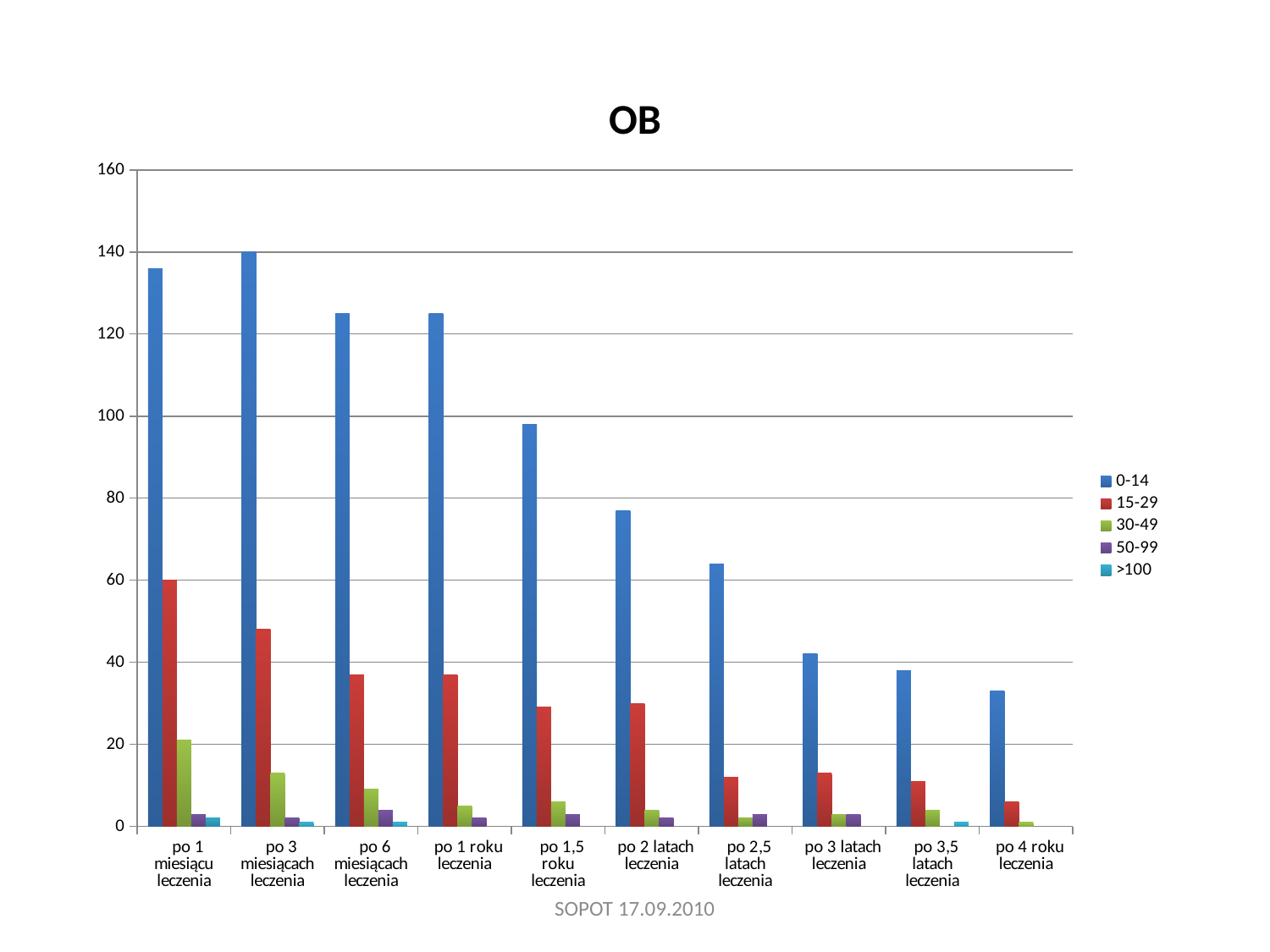
Do the values of the 0-14 series generally rise or fall along the x axis? fall How many categories are shown along the x axis? 10 What kind of chart is shown on the slide? bar chart Is the value for the 15-29 series at 'po 1 miesiącu leczenia' greater or less than 40? greater How many series does the legend list? 5 Which category has the lowest value for the 0-14 series? po 4 roku leczenia Which legend entry is shown in teal (the last entry)? >100 Which category has the highest value for the 0-14 series? po 3 miesiącach leczenia At 'po 2 latach leczenia', which series has the larger value, 0-14 or 15-29? 0-14 Is the value for the 0-14 series at 'po 2,5 latach leczenia' greater or less than 60? greater What is the title of the chart? OB Is the value for the 0-14 series at 'po 1,5 roku leczenia' greater or less than 100? less